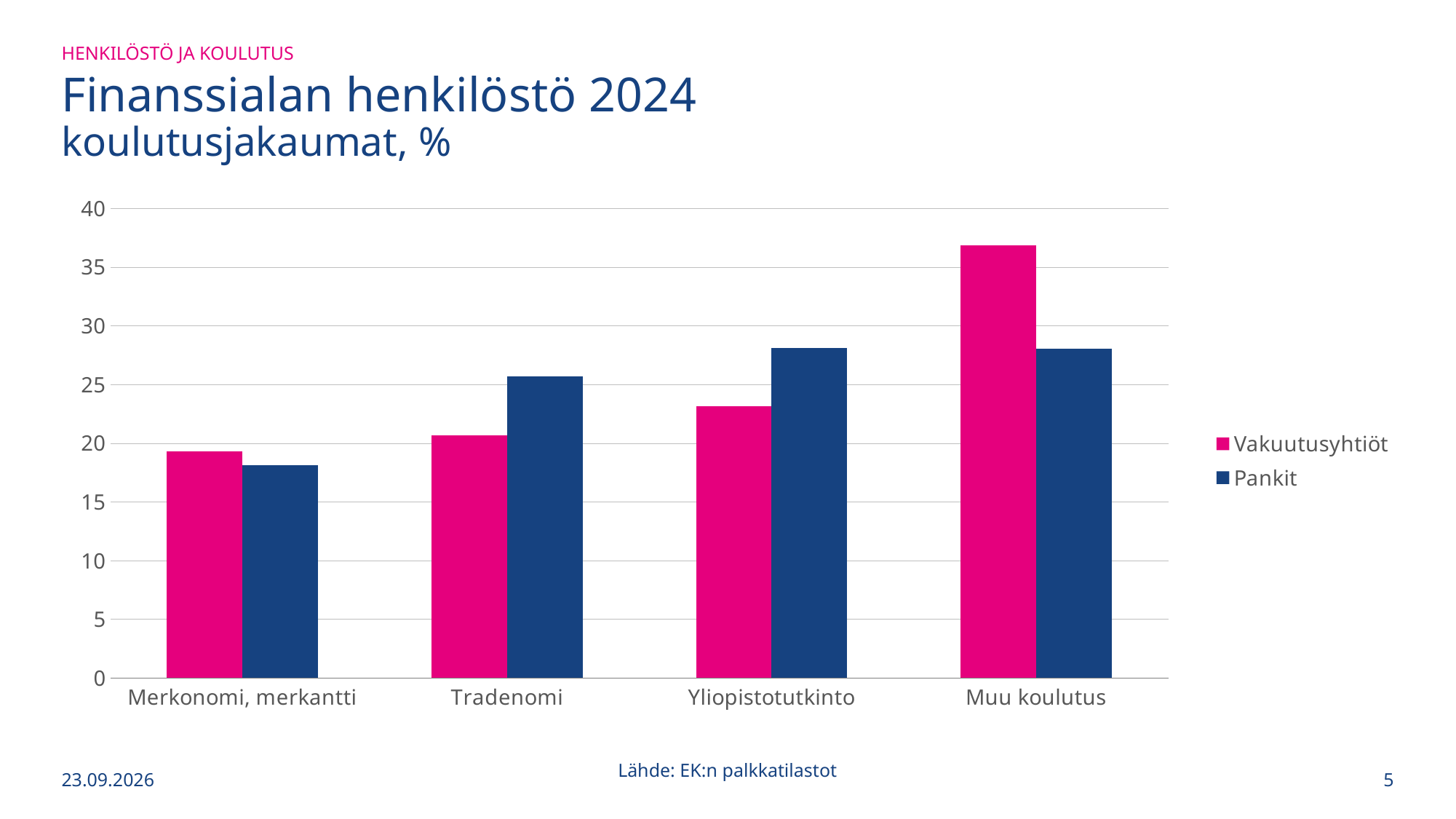
How many series does the legend list? 2 What kind of chart is shown on the slide? bar chart Which category has the highest value for Vakuutusyhtiöt? Muu koulutus In the Muu koulutus category, which series has the larger value, Vakuutusyhtiöt or Pankit? Vakuutusyhtiöt Is the value for Vakuutusyhtiöt in Yliopistotutkinto greater or less than 25? less Which category has the lowest value for Vakuutusyhtiöt? Merkonomi, merkantti Which category has the lowest value for Pankit? Merkonomi, merkantti How many education categories are shown on the x axis? 4 Is the value for Vakuutusyhtiöt in Muu koulutus greater or less than 35? greater In the Tradenomi category, which series has the larger value, Vakuutusyhtiöt or Pankit? Pankit Is the value for Pankit in Tradenomi greater or less than 25? greater Do the values for Vakuutusyhtiöt rise or fall from Merkonomi, merkantti to Muu koulutus? rise